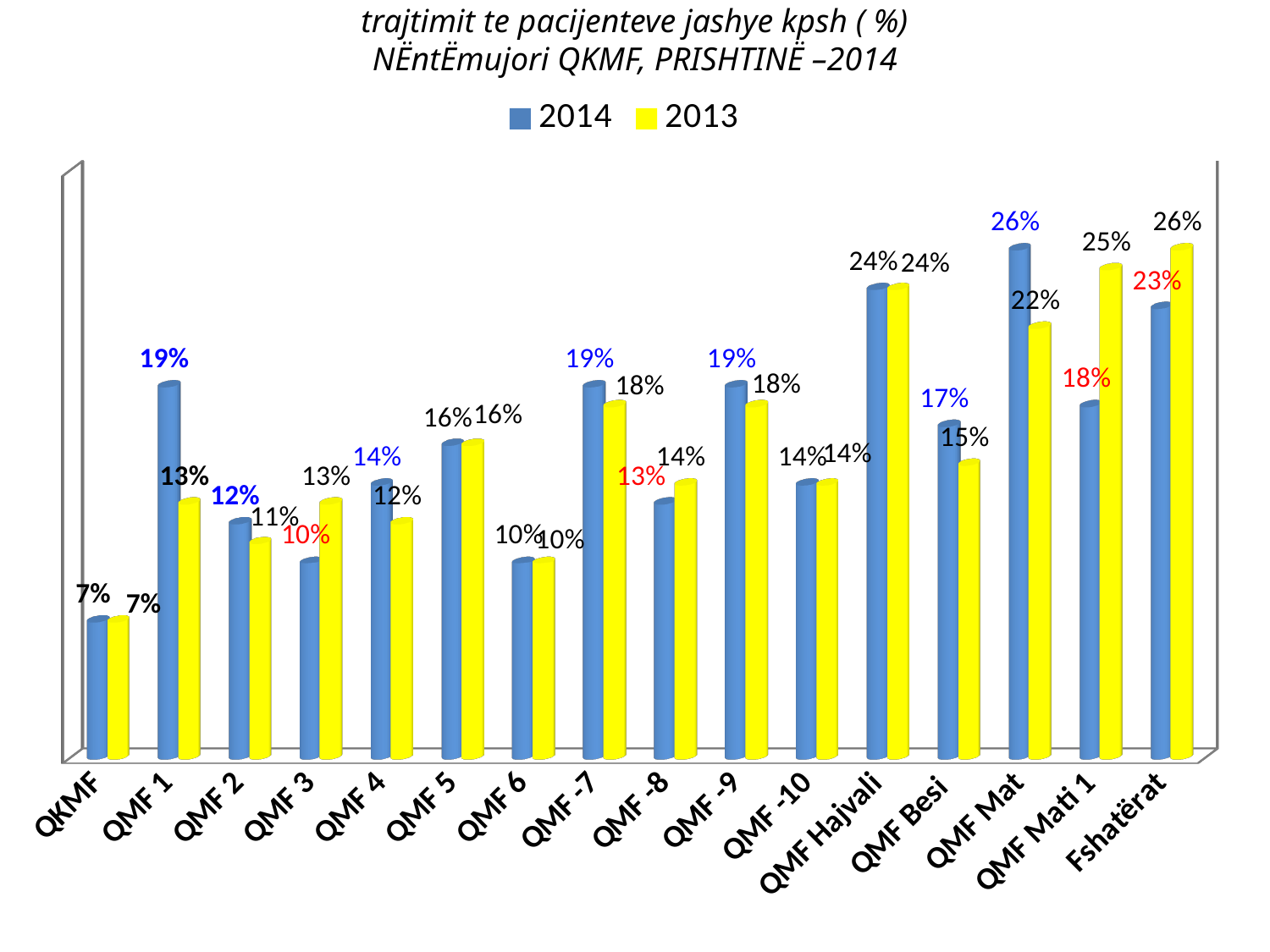
What is the 2014 value for QMF Mat? 26% Which is larger for Fshatërat, the 2014 value or the 2013 value? 2013 What is the difference between the 2014 and 2013 values for QMF 1? 6% What is the 2013 value for QMF Mati 1? 25% What kind of chart is shown on the slide? Bar chart How many categories are shown on the x axis? 16 What is the difference between the 2013 and 2014 values for QMF Mati 1? 7% Which category has the lowest 2013 value? QKMF Which category has the highest 2014 value? QMF Mat How many series does the legend list? 2 What is the 2014 value for QMF Besi? 17% Which is larger for QMF Mat, the 2014 value or the 2013 value? 2014